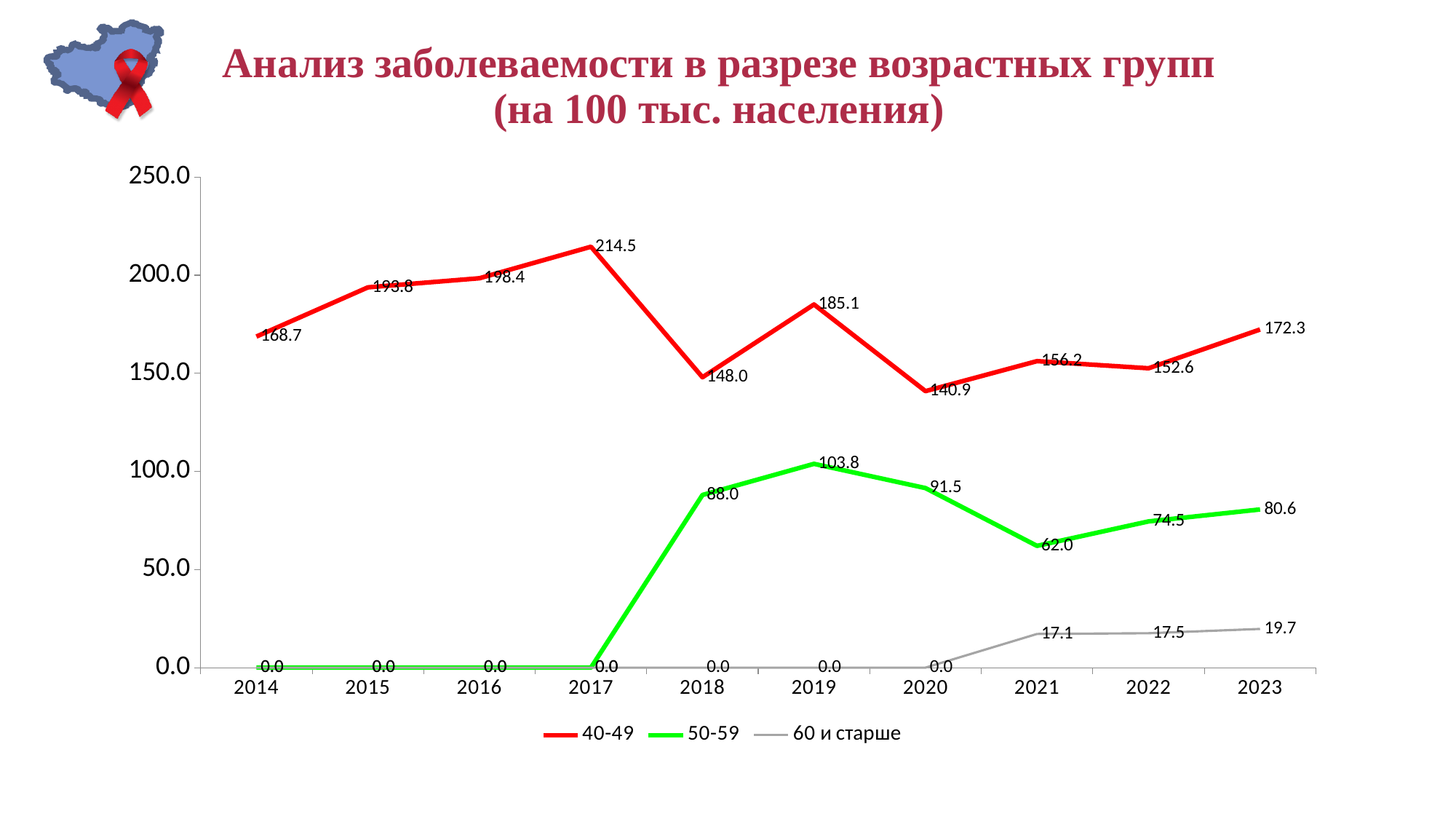
What is the value for the 50-59 series in 2019? 103.8 Which is larger: the 50-59 value in 2021 or in 2022? 2022 Does the 40-49 series rise or fall from 2020 to 2021? rise What is the difference between the 40-49 value in 2017 and in 2018? 66.5 How many series does the legend list? 3 In which year does the 40-49 series have its lowest value? 2020 What colour is the line for the 50-59 series? green What is the value for the 40-49 series in 2017? 214.5 In which year does the 40-49 series reach its highest value? 2017 How many years are shown on the x axis? 10 What is the value for the 60 и старше series in 2023? 19.7 What type of chart is shown on the slide? line chart